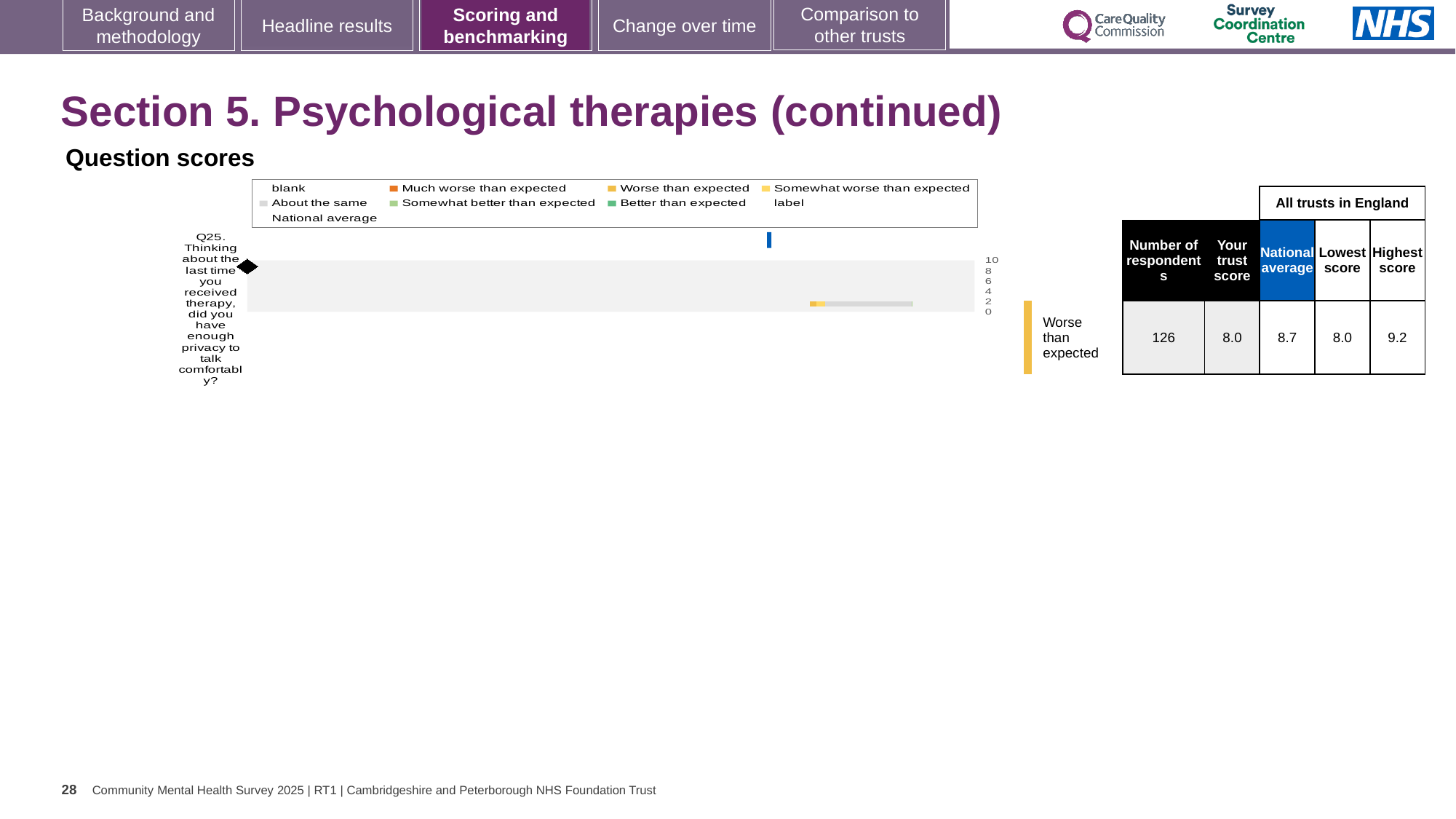
In the table next to the chart, what is the difference between the highest score and the lowest score for Q25? 1.2 In the table next to the chart, which is larger for Q25: the trust score or the national average? national average What kind of chart is shown under 'Question scores'? bar chart Which question number is plotted in the Question scores chart? Q25 In the table next to the chart, what is 'Your trust score' for Q25? 8.0 What benchmark category label is shown to the right of the Question scores chart for Q25? Worse than expected In the table next to the chart, what is the number of respondents for Q25? 126 How many questions (categories) are plotted in the Question scores chart? 1 What is the highest value shown on the axis of the Question scores chart? 10 In the table next to the chart, what is the lowest score among all trusts in England for Q25? 8.0 In the table next to the chart, what is the national average for Q25? 8.7 In the table next to the chart, what is the highest score among all trusts in England for Q25? 9.2